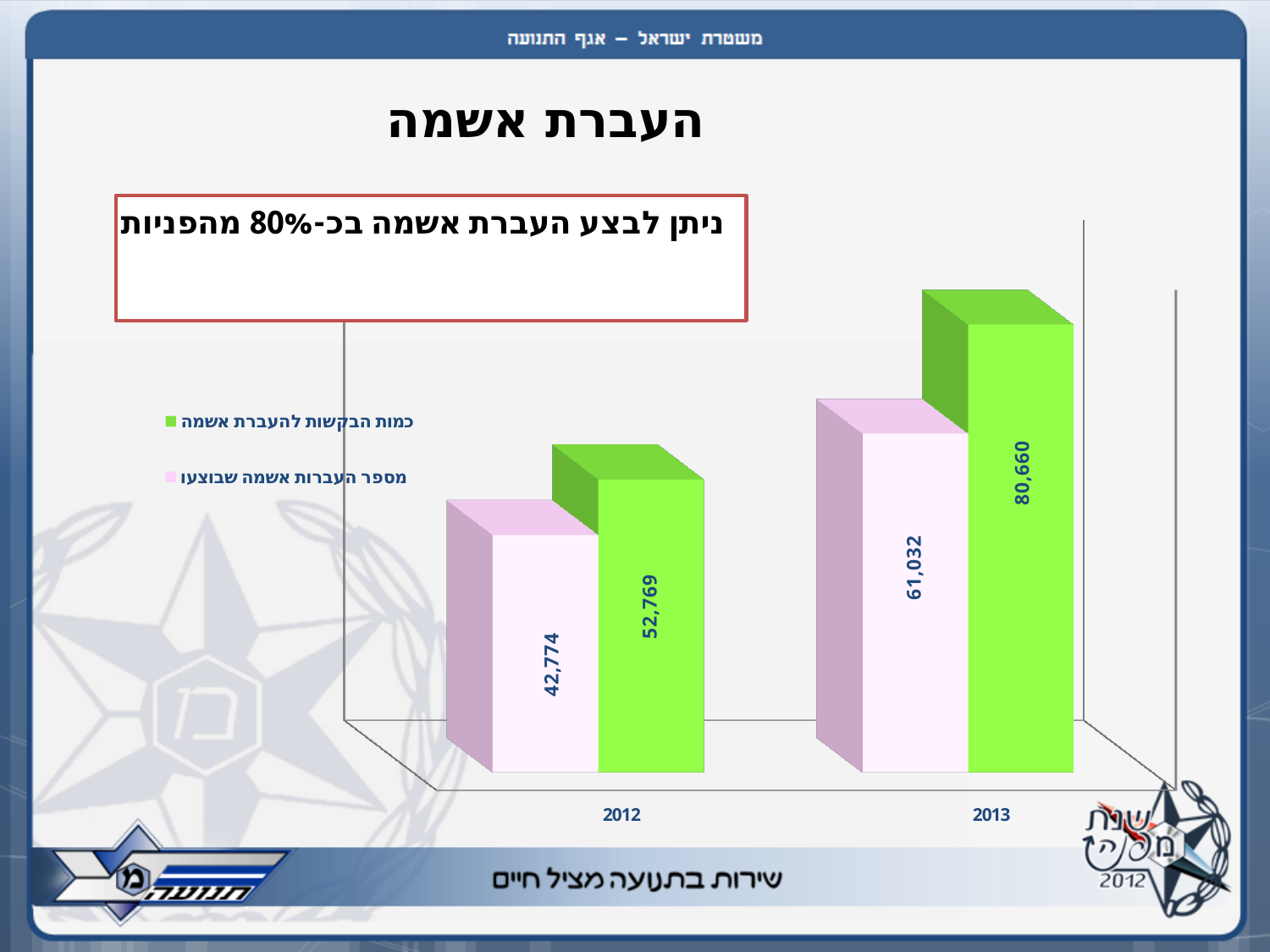
How many years (categories) are shown on the x axis? 2 Which year has the highest value for the green series (כמות הבקשות להעברת אשמה)? 2013 What is the difference between the green and pink values for 2013? 19,628 What kind of chart is shown on the slide? Bar chart What is the difference between the pink series values for 2013 and 2012? 18,258 Which is larger: the green value for 2012 or the pink value for 2013? The pink value for 2013 (61,032) How many series does the legend list? 2 What is the value of the green series (כמות הבקשות להעברת אשמה) for 2012? 52,769 What is the value of the pink series (מספר העברות אשמה שבוצעו) for 2013? 61,032 What is the value of the green series (כמות הבקשות להעברת אשמה) for 2013? 80,660 Which bar on the chart has the lowest value? מספר העברות אשמה שבוצעו in 2012 (42,774) What is the value of the pink series (מספר העברות אשמה שבוצעו) for 2012? 42,774